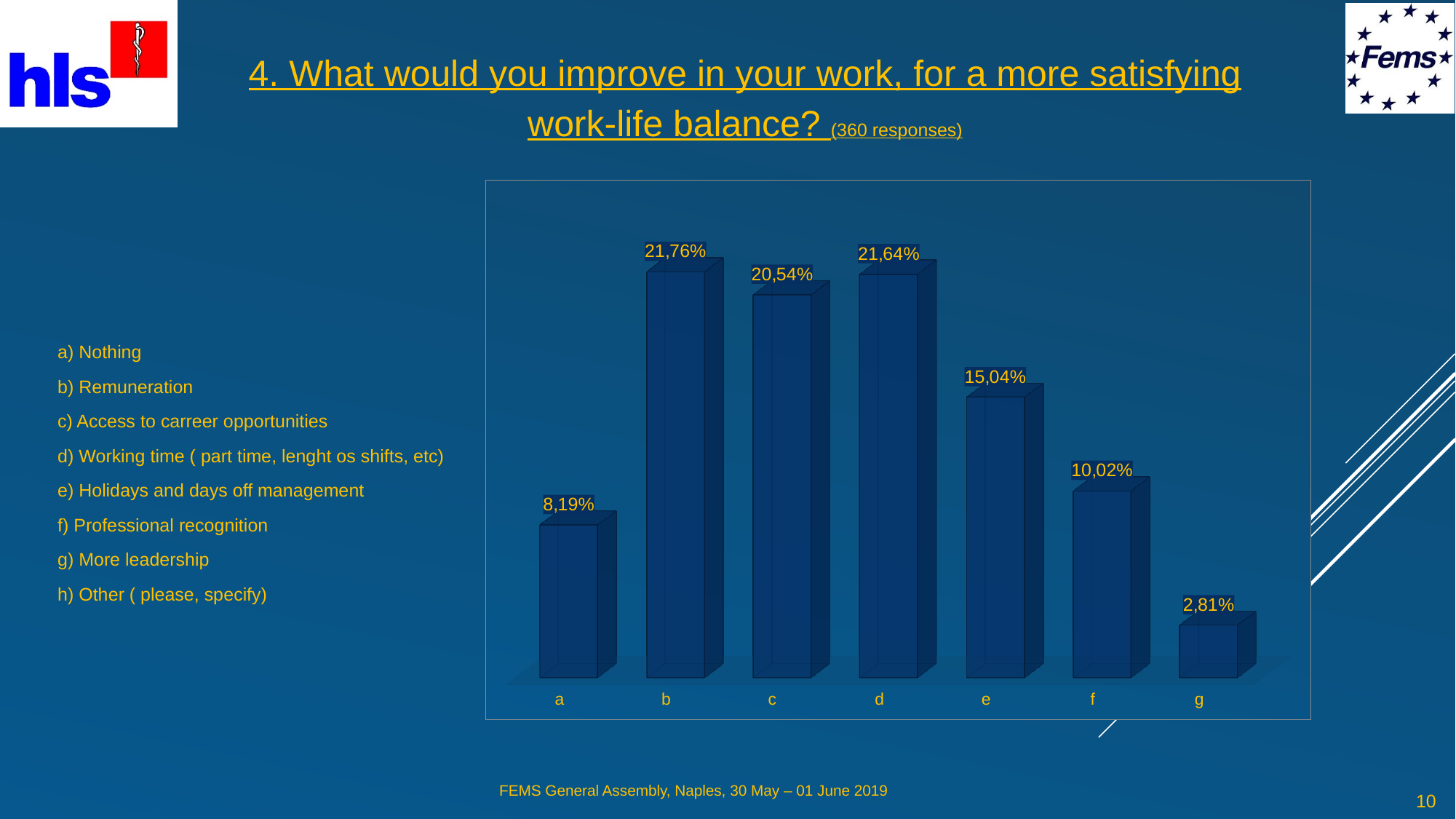
Which category has the highest value? b What is the value for category b? 21,76% Which is larger, the value for c or the value for e? c What is the value for category g? 2,81% What kind of chart is shown on the slide? bar chart What is the value for category a? 8,19% What is the value for category e? 15,04% What is the difference between the values for b and a? 13,57% According to the list on the slide, what does category b stand for? Remuneration Which category has the lowest value? g What is the difference between the values for f and g? 7,21% How many categories are shown in the chart? 7